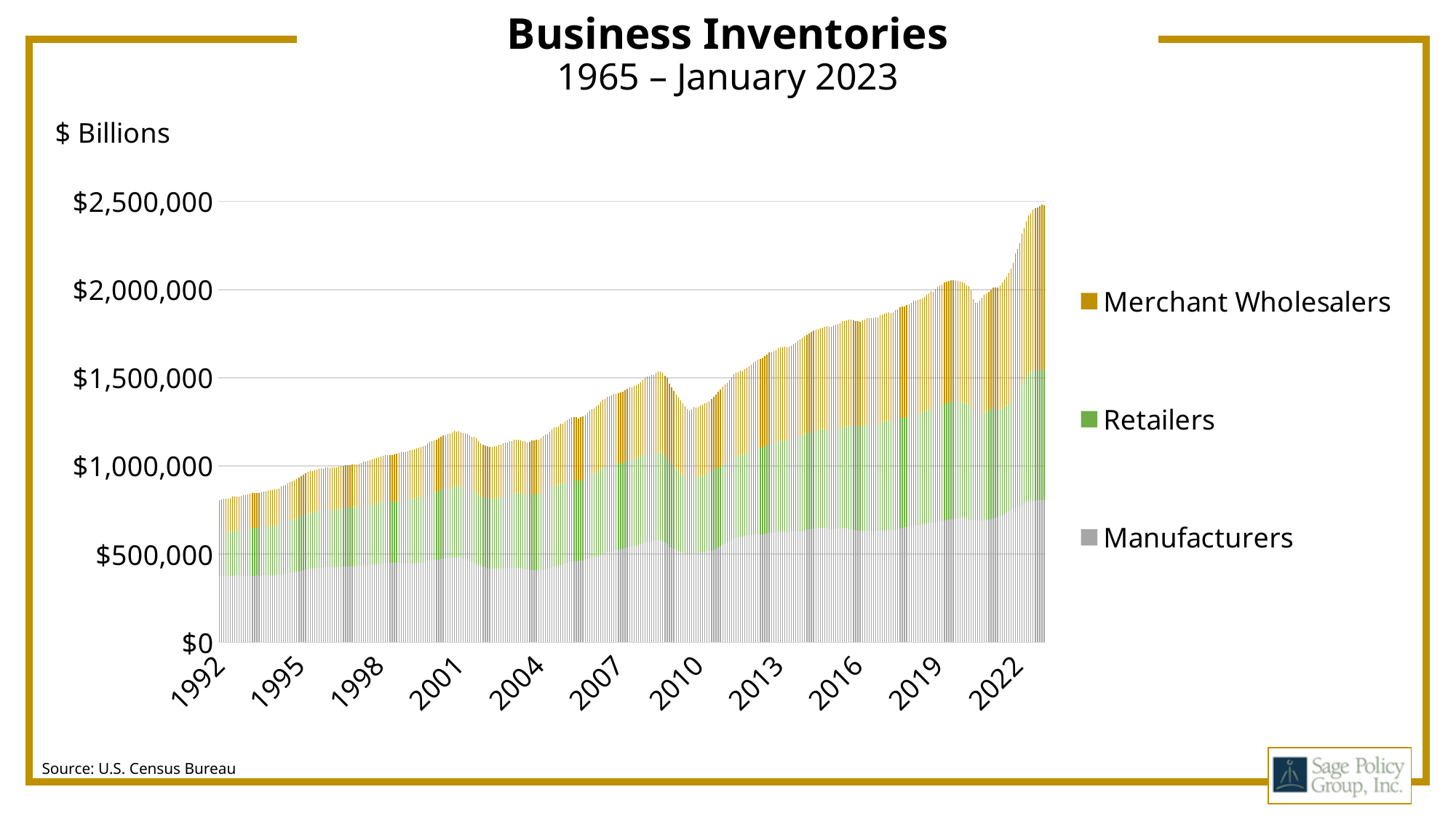
Is the total stacked value at 2010 greater or less than $1,000,000? greater Is the total stacked value at 2022 greater or less than $2,000,000? greater Is the total stacked value at 1992 greater or less than $1,000,000? less How many year labels are shown on the x axis? 11 Which series forms the bottom segment of each stacked bar? Manufacturers Do total business inventories generally rise or fall from 1992 to 2022? Rise Which series is shown in green in the legend? Retailers How many series does the legend list? 3 What is the title of the chart? Business Inventories What kind of chart is shown on the slide? Stacked bar chart